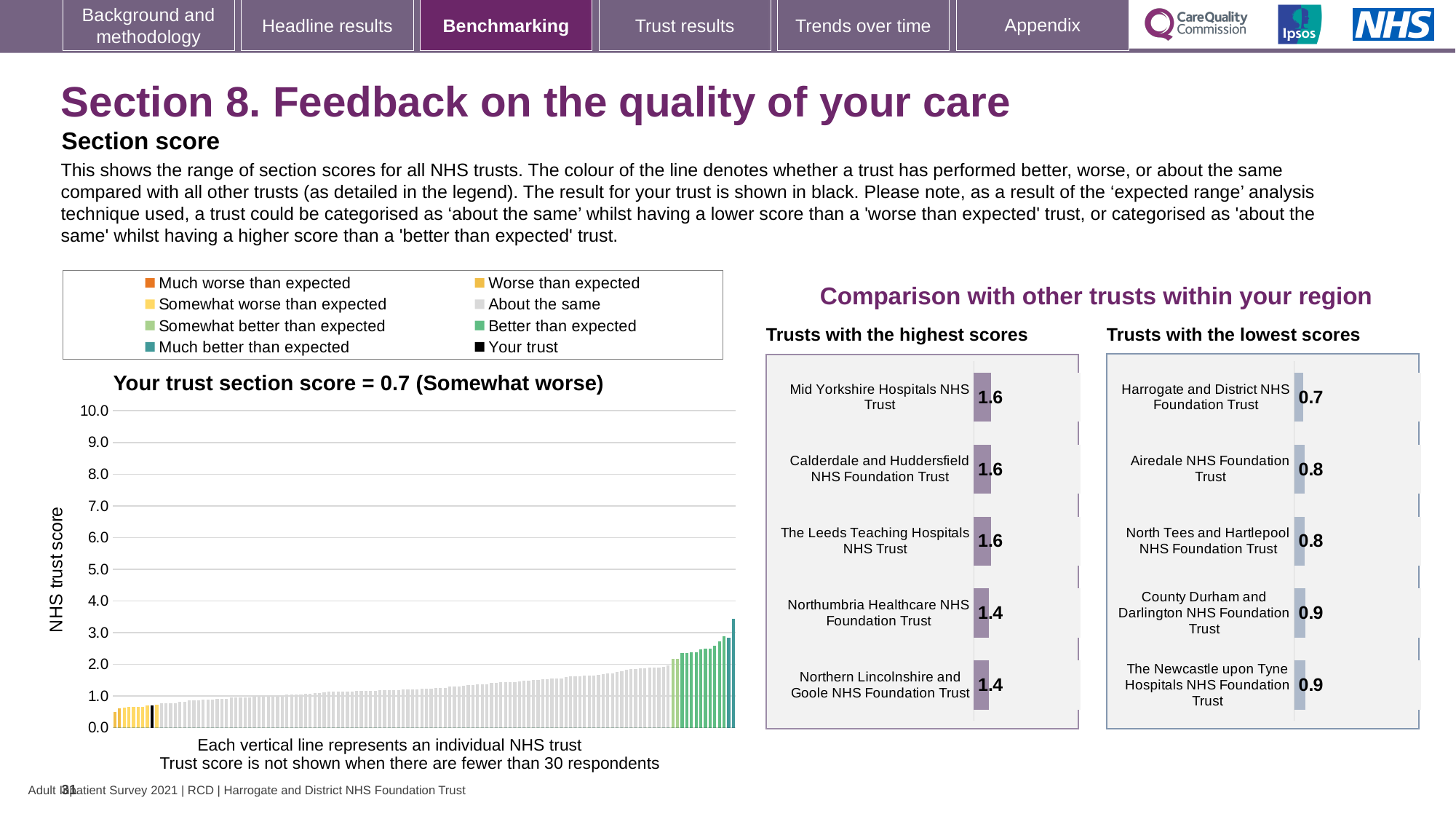
In the main chart on the left, do the trust scores rise or fall from left to right along the x axis? rise What kind of chart is the main chart titled 'Your trust section score = 0.7 (Somewhat worse)'? bar chart In the 'Trusts with the lowest scores' chart, what is the score for Airedale NHS Foundation Trust? 0.8 In the 'Trusts with the lowest scores' chart, what is the difference between the score for The Newcastle upon Tyne Hospitals NHS Foundation Trust and the score for Harrogate and District NHS Foundation Trust? 0.2 What is the section score for your trust shown in the title of the main chart on the left? 0.7 How many entries does the legend above the main chart list? 8 In the 'Trusts with the lowest scores' chart, which has the larger score: Airedale NHS Foundation Trust or County Durham and Darlington NHS Foundation Trust? County Durham and Darlington NHS Foundation Trust In the 'Trusts with the lowest scores' chart, which trust has the lowest score? Harrogate and District NHS Foundation Trust In the 'Trusts with the highest scores' chart, what is the score for Mid Yorkshire Hospitals NHS Trust? 1.6 In the 'Trusts with the highest scores' chart, what is the score for Northumbria Healthcare NHS Foundation Trust? 1.4 How many trusts are listed in the 'Trusts with the highest scores' chart? 5 In the 'Trusts with the highest scores' chart, what is the difference between the score for The Leeds Teaching Hospitals NHS Trust and the score for Northern Lincolnshire and Goole NHS Foundation Trust? 0.2